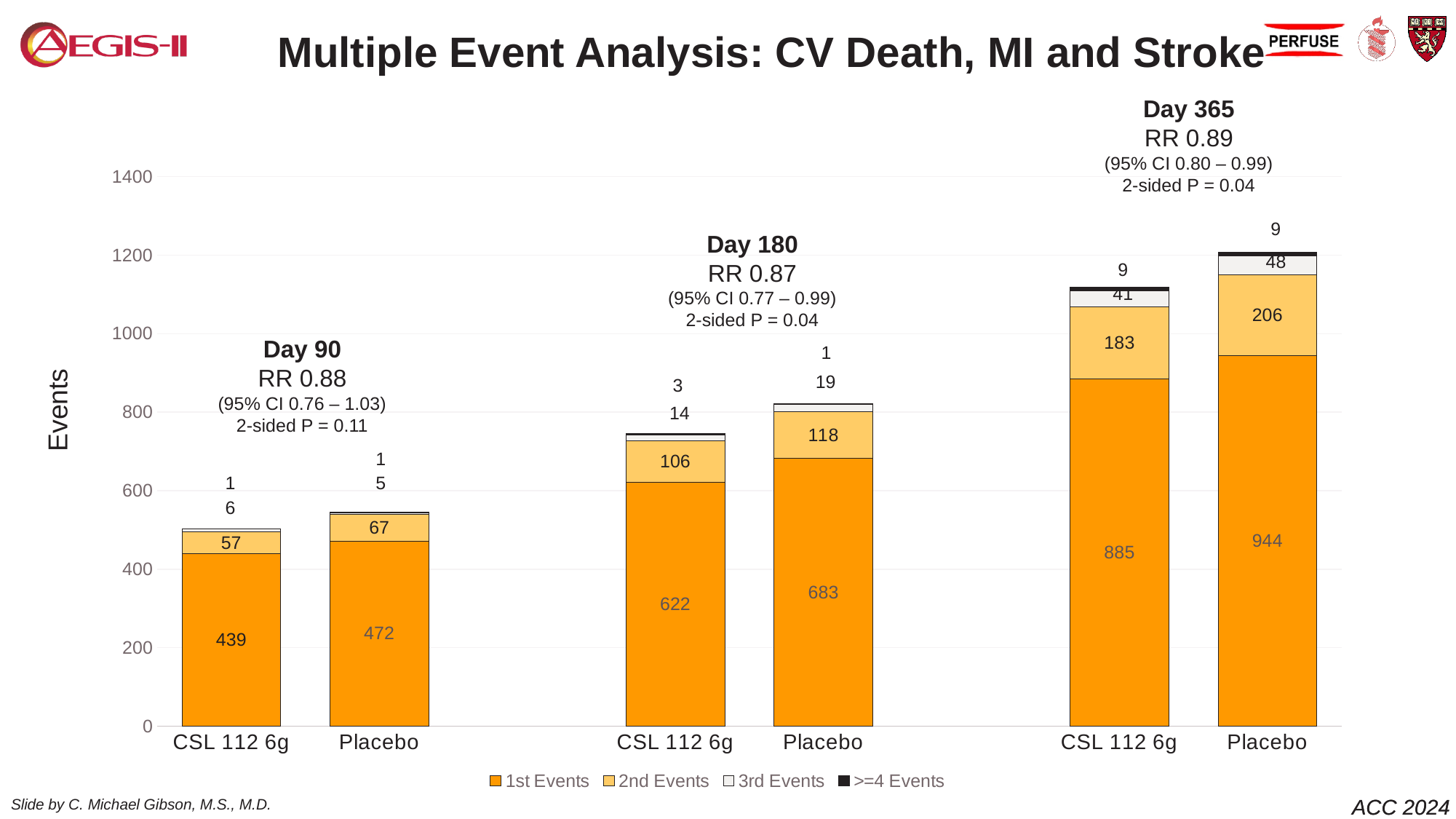
What is the number of 1st Events for CSL 112 6g at Day 90? 439 Which bar has the highest number of 1st Events? Placebo at Day 365 What is the total number of events in the CSL 112 6g bar at Day 90? 503 Which bar has the lowest number of 2nd Events? CSL 112 6g at Day 90 What is the number of 3rd Events for Placebo at Day 365? 48 Is the total height of the Placebo bar at Day 365 greater or less than 1200? greater What is the number of >=4 Events for CSL 112 6g at Day 180? 3 How many bars are plotted in the chart? 6 What is the number of 2nd Events for Placebo at Day 180? 118 How many series does the legend list? 4 What is the difference in 1st Events between Placebo and CSL 112 6g at Day 365? 59 What kind of chart is shown on the slide? Stacked bar chart